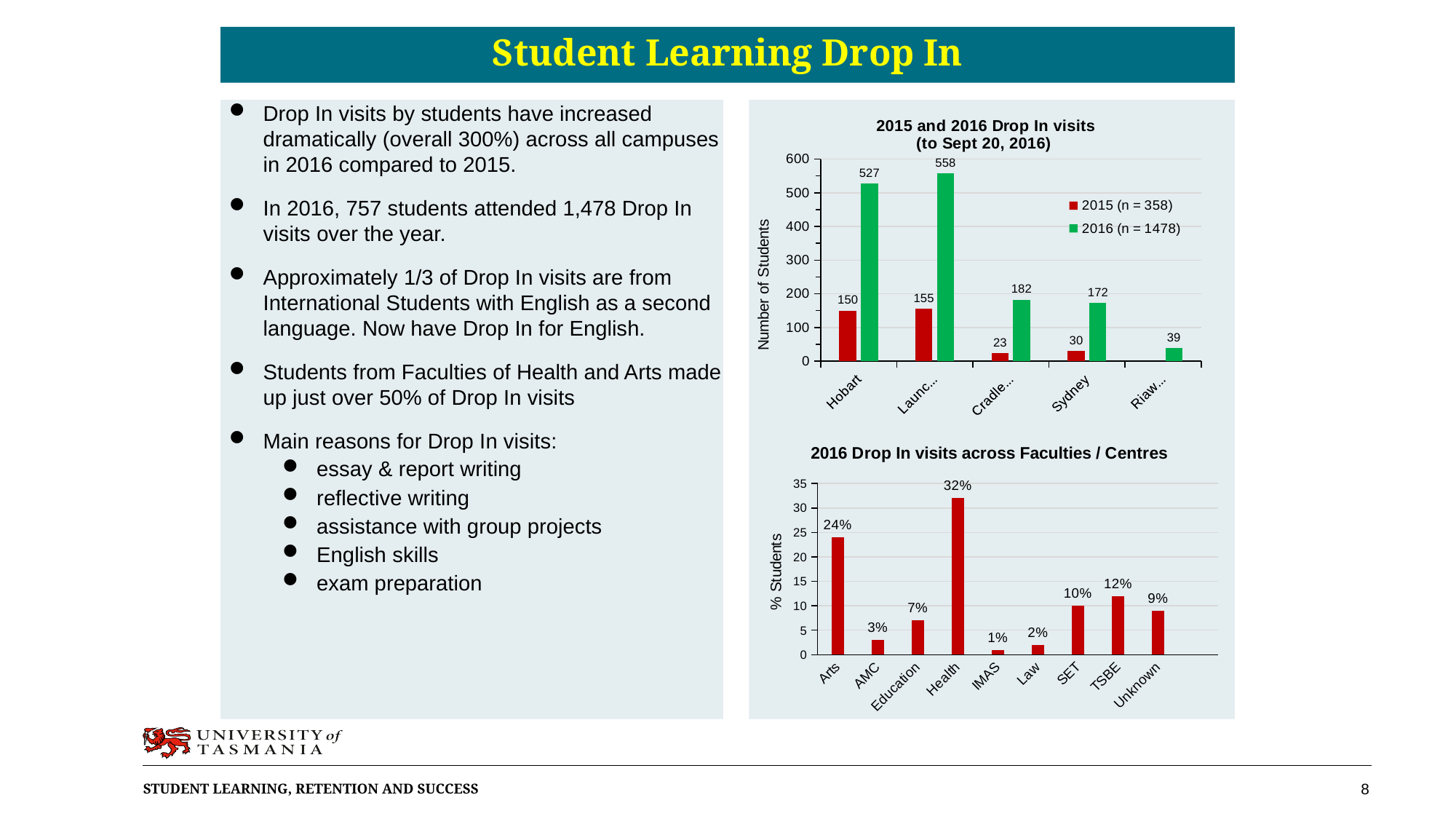
In the chart titled '2016 Drop In visits across Faculties / Centres', what is the difference between the values for Arts and Education? 17% In the chart titled '2016 Drop In visits across Faculties / Centres', which faculty or centre has the highest value? Health In the chart titled '2016 Drop In visits across Faculties / Centres', what is the value for TSBE? 12% In the chart titled '2016 Drop In visits across Faculties / Centres', which faculty or centre has the lowest value? IMAS In the chart titled '2015 and 2016 Drop In visits (to Sept 20, 2016)', what is the difference between the 2016 and 2015 values for Hobart? 377 In the chart titled '2015 and 2016 Drop In visits (to Sept 20, 2016)', what colour are the 2016 bars? Green In the chart titled '2015 and 2016 Drop In visits (to Sept 20, 2016)', which is larger for Sydney: the 2015 value or the 2016 value? 2016 In the chart titled '2015 and 2016 Drop In visits (to Sept 20, 2016)', how many series does the legend list? 2 In the chart titled '2015 and 2016 Drop In visits (to Sept 20, 2016)', what is the 2015 value for Sydney? 30 In the chart titled '2016 Drop In visits across Faculties / Centres', how many faculties or centres are shown on the x axis? 9 What kind of chart is the chart titled '2016 Drop In visits across Faculties / Centres'? Bar chart In the chart titled '2015 and 2016 Drop In visits (to Sept 20, 2016)', what is the 2016 value for Hobart? 527